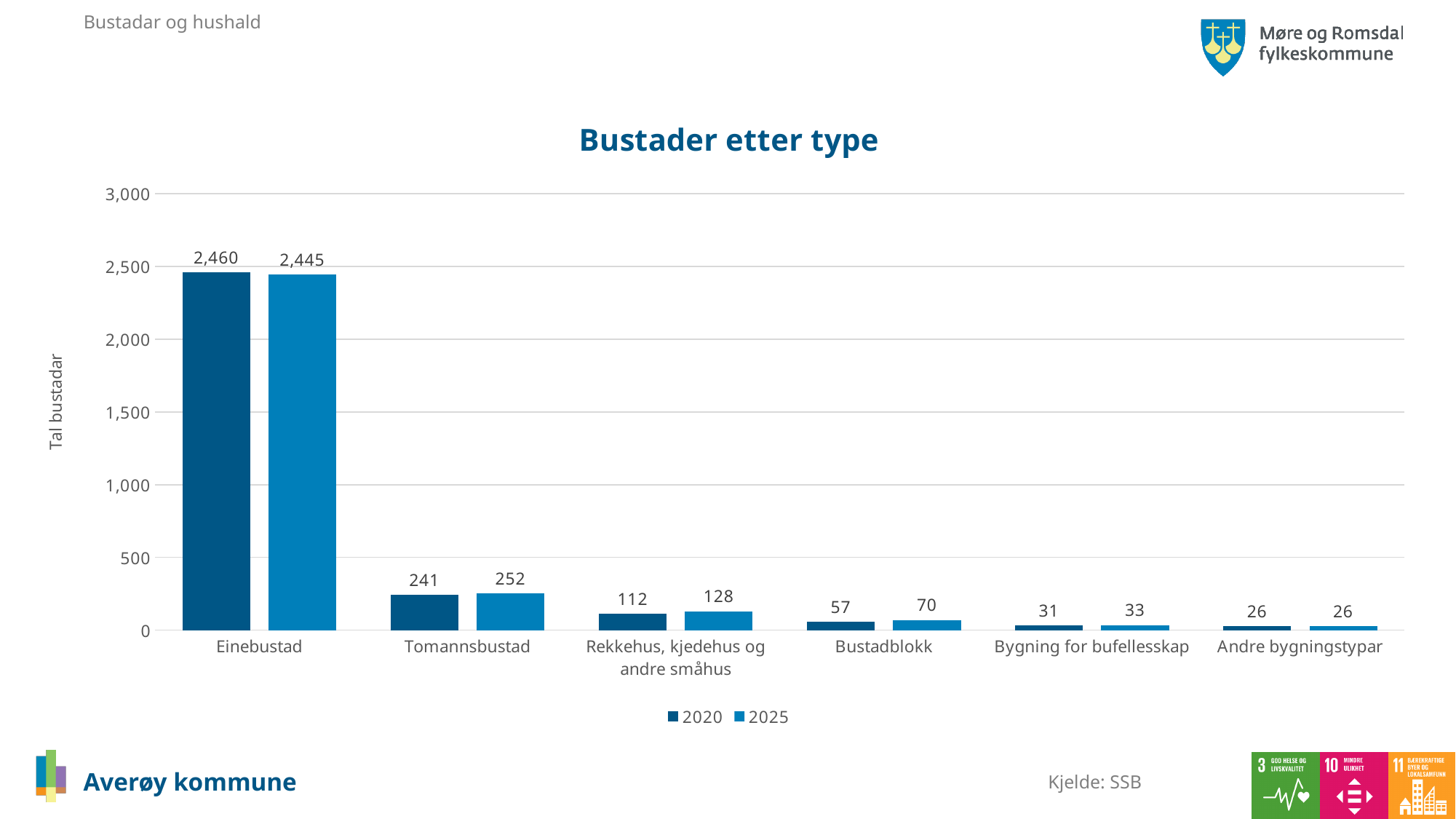
Which category has the lowest value in 2020? Andre bygningstypar What is the value for Tomannsbustad in 2025? 252 How many categories are shown on the x axis? 6 What is the value for Rekkehus, kjedehus og andre småhus in 2025? 128 What is the title of the chart? Bustader etter type What kind of chart is shown on the slide? Bar chart What is the value for Bustadblokk in 2020? 57 What is the value for Einebustad in 2020? 2,460 What is the difference between the 2020 and 2025 values for Einebustad? 15 Which category has the highest value in 2025? Einebustad How many series does the legend list? 2 Which is larger for Bustadblokk: the 2020 value or the 2025 value? 2025